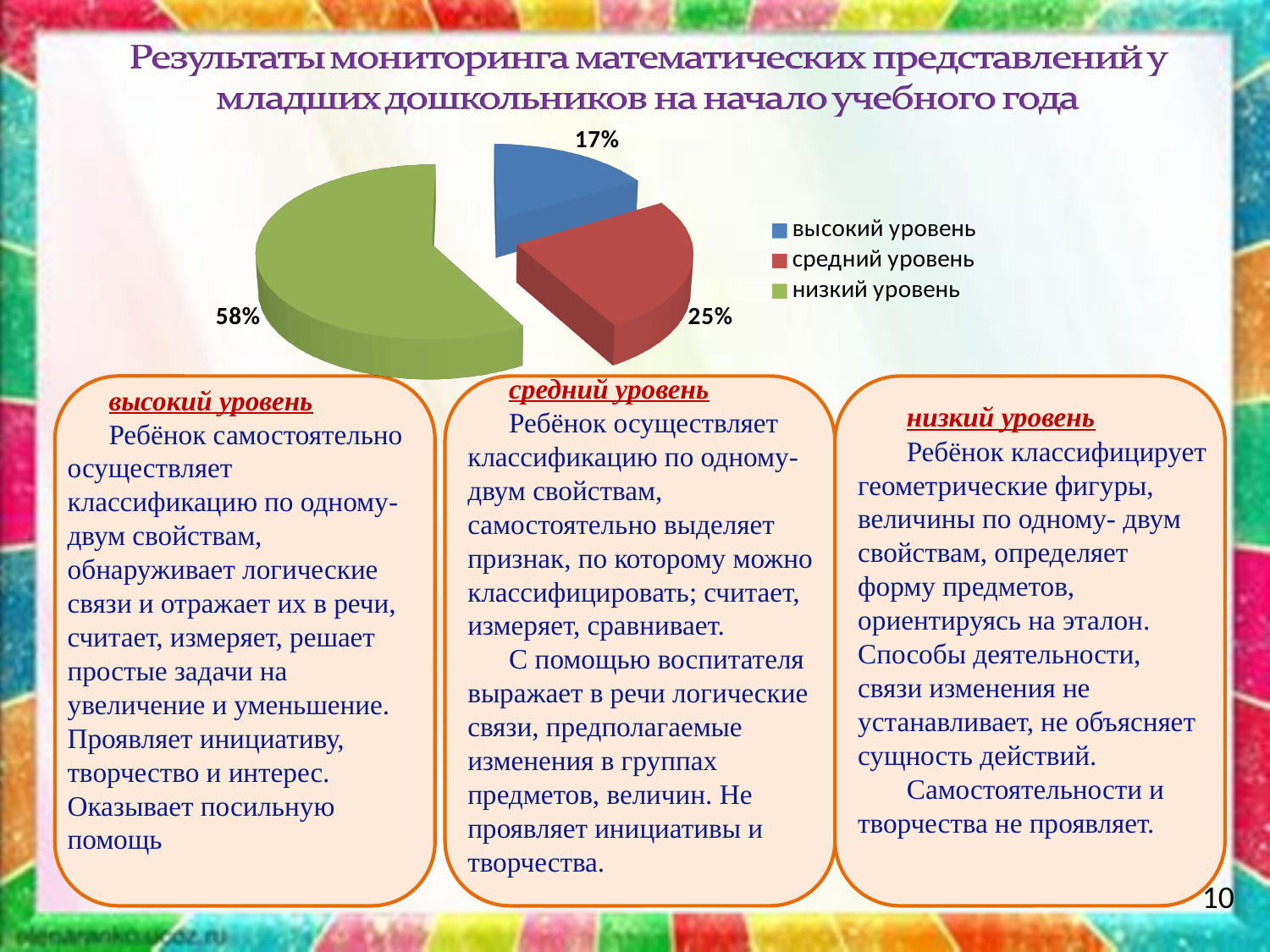
Which is larger, the share for "средний уровень" or the share for "высокий уровень"? средний уровень How many slices does the pie chart have? 3 What kind of chart is shown on the slide? pie chart What colour is the slice for "низкий уровень"? green Which level has the largest share of the pie? низкий уровень Which level has the smallest share of the pie? высокий уровень What share of the pie does "средний уровень" have? 25% What is the difference in percentage points between "низкий уровень" and "средний уровень"? 33 How many entries does the legend list? 3 What is the difference in percentage points between "средний уровень" and "высокий уровень"? 8 What share of the pie does "высокий уровень" have? 17% What share of the pie does "низкий уровень" have? 58%